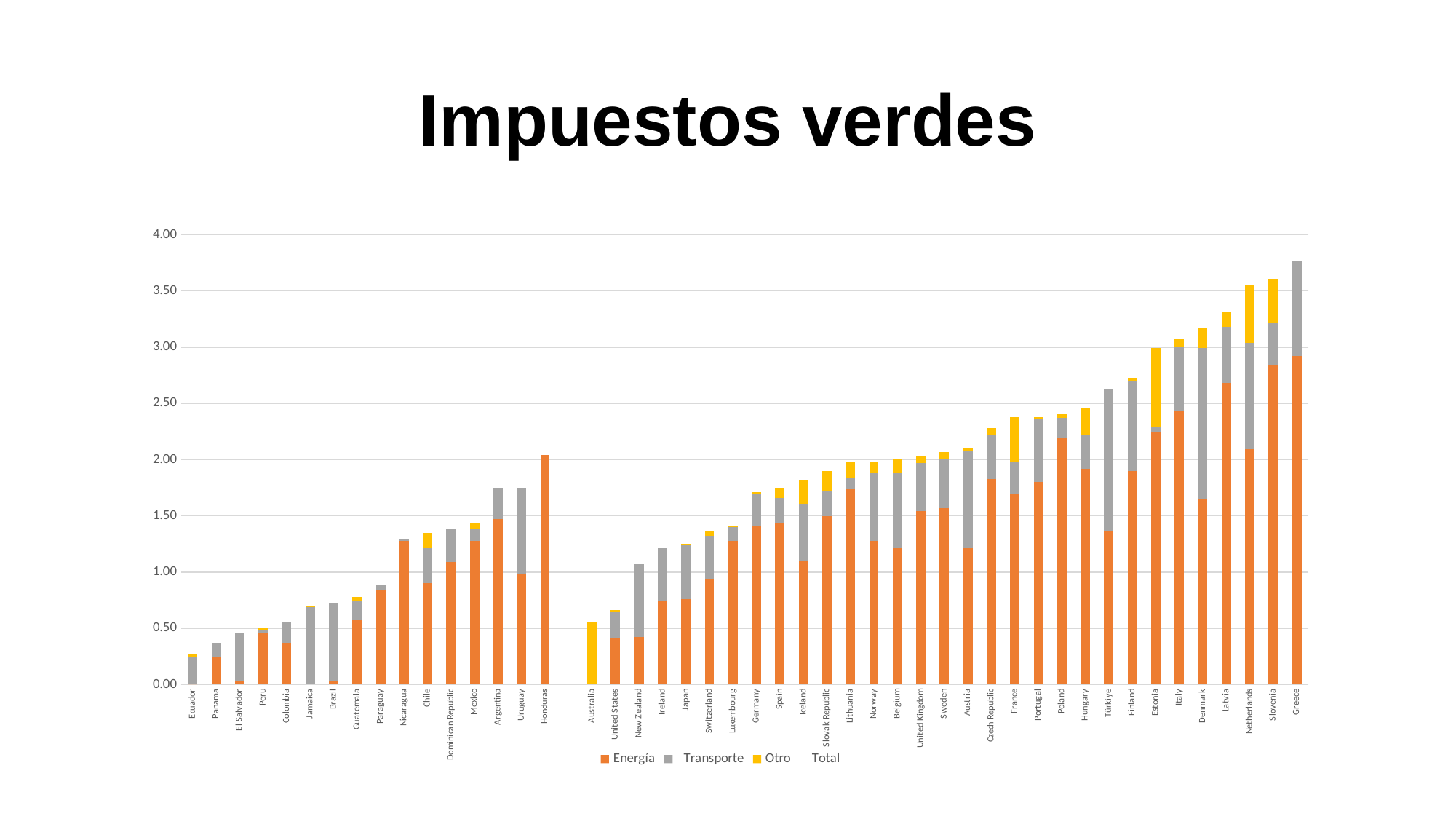
Which colour represents the Energía series? Orange What kind of chart is shown on the slide? Bar chart Do the total bar heights generally rise or fall from left to right across the chart? rise How many series does the legend list? 4 Is the total value for Australia greater or less than 1.00? less Which country has the lowest total bar? Ecuador Is the total value for Greece greater or less than 3.50? greater Which country has the highest total bar? Greece Which has the larger total bar, Honduras or Uruguay? Honduras Is the total value for Honduras greater or less than 1.50? greater What is the title of the chart? Impuestos verdes